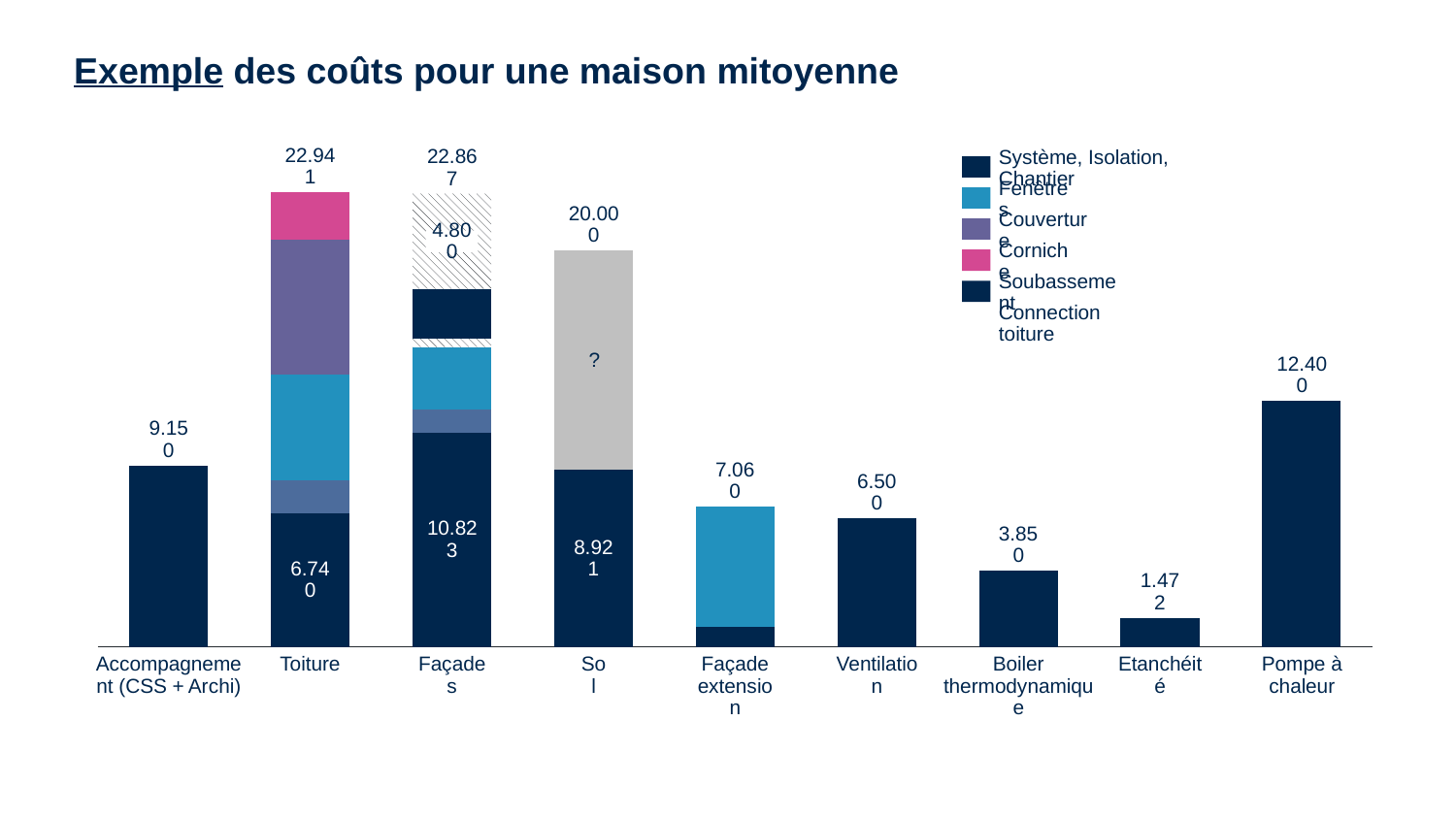
Which category has the highest total value? Toiture What is the total value shown for Accompagnement (CSS + Archi)? 9.150 What is the total value shown above the Toiture bar? 22.941 What kind of chart is shown on the slide? Stacked bar chart Which category has the lowest total value? Etanchéité What is the value shown for Pompe à chaleur? 12.400 What value is printed on the hatched top segment of the Façades bar? 4.800 What value is printed on the bottom (dark blue) segment of the Façades bar? 10.823 How many series does the legend list? 6 Which is larger, the value for Ventilation or the value for Boiler thermodynamique? Ventilation How many categories are shown on the x axis? 9 What is the difference between the total for Toiture and the value for Accompagnement (CSS + Archi)? 13.791